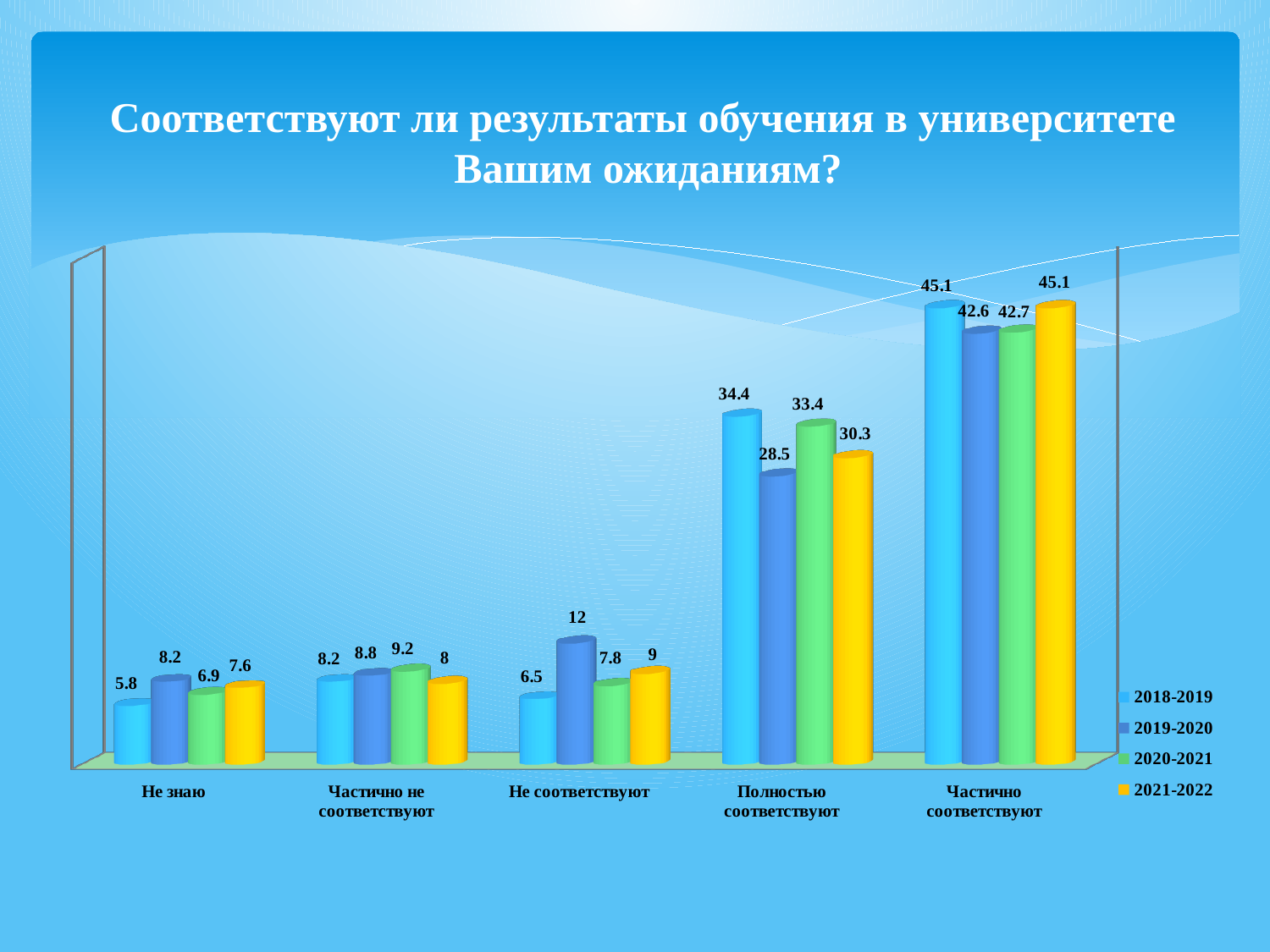
For "Не соответствуют", which is larger: the 2019-2020 value or the 2021-2022 value? 2019-2020 Which series is shown in yellow in the legend? 2021-2022 What is the value for "Не соответствуют" in the 2019-2020 series? 12 Which category has the lowest value in the 2021-2022 series? Не знаю How many series does the legend list? 4 What kind of chart is shown on the slide? Bar chart Which category has the highest value in the 2018-2019 series? Частично соответствуют What is the value for "Не знаю" in the 2018-2019 series? 5.8 What is the value for "Полностью соответствуют" in the 2021-2022 series? 30.3 What is the difference between the 2018-2019 and 2019-2020 values for "Полностью соответствуют"? 5.9 How many categories are shown on the x axis? 5 What is the value for "Частично соответствуют" in the 2020-2021 series? 42.7